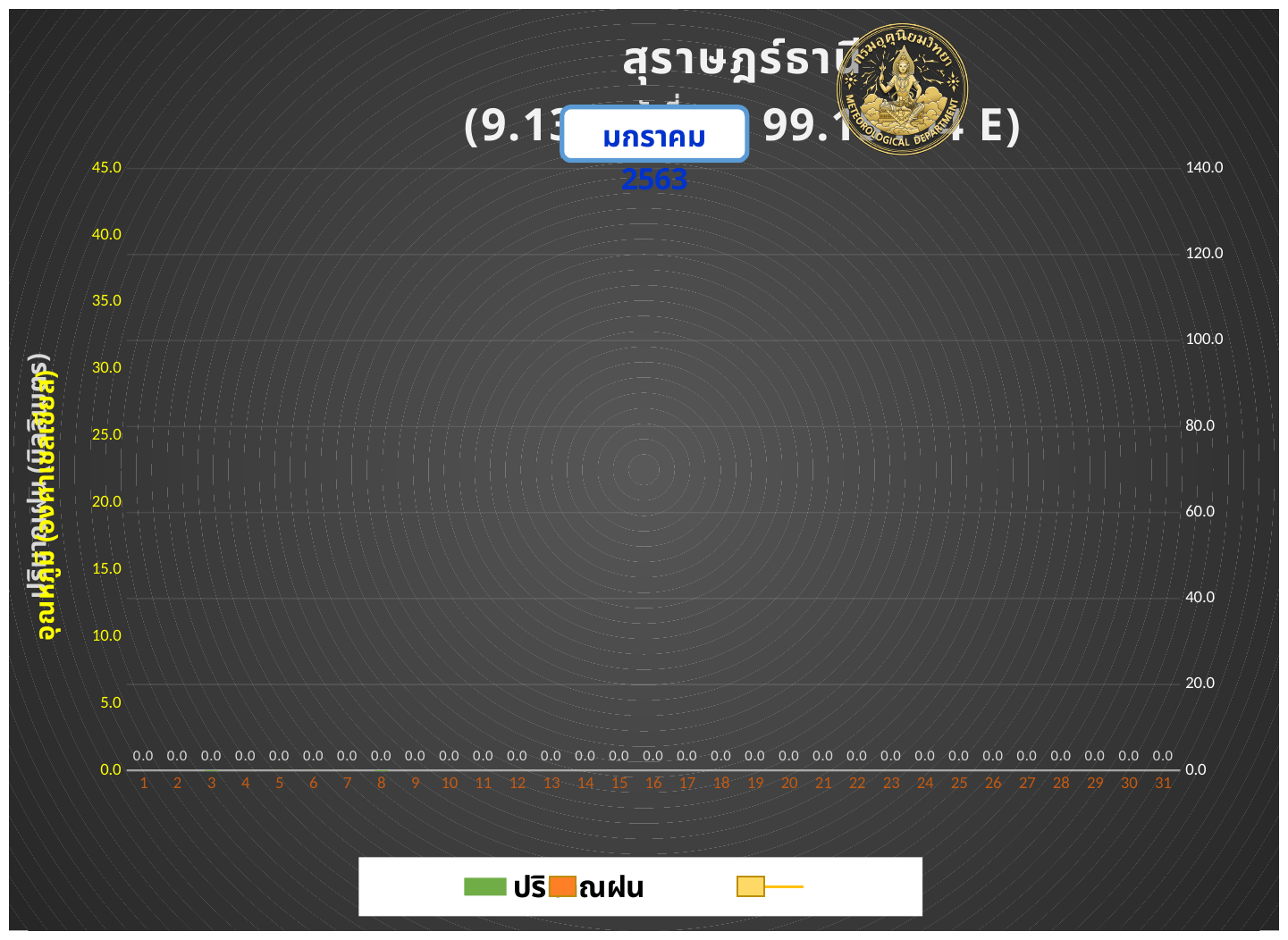
What is the value shown for day 15 on the chart? 0.0 What month and year are shown above the chart? มกราคม 2563 What is the value shown for day 20 on the chart? 0.0 Is the value for day 10 greater or less than 5.0? less How many days are shown along the x axis of the chart? 31 What is the highest tick value on the left vertical axis of the chart? 45.0 Is the value for day 25 greater or less than 20.0? less What is the value shown for day 1 on the chart? 0.0 What is the value shown for day 31 on the chart? 0.0